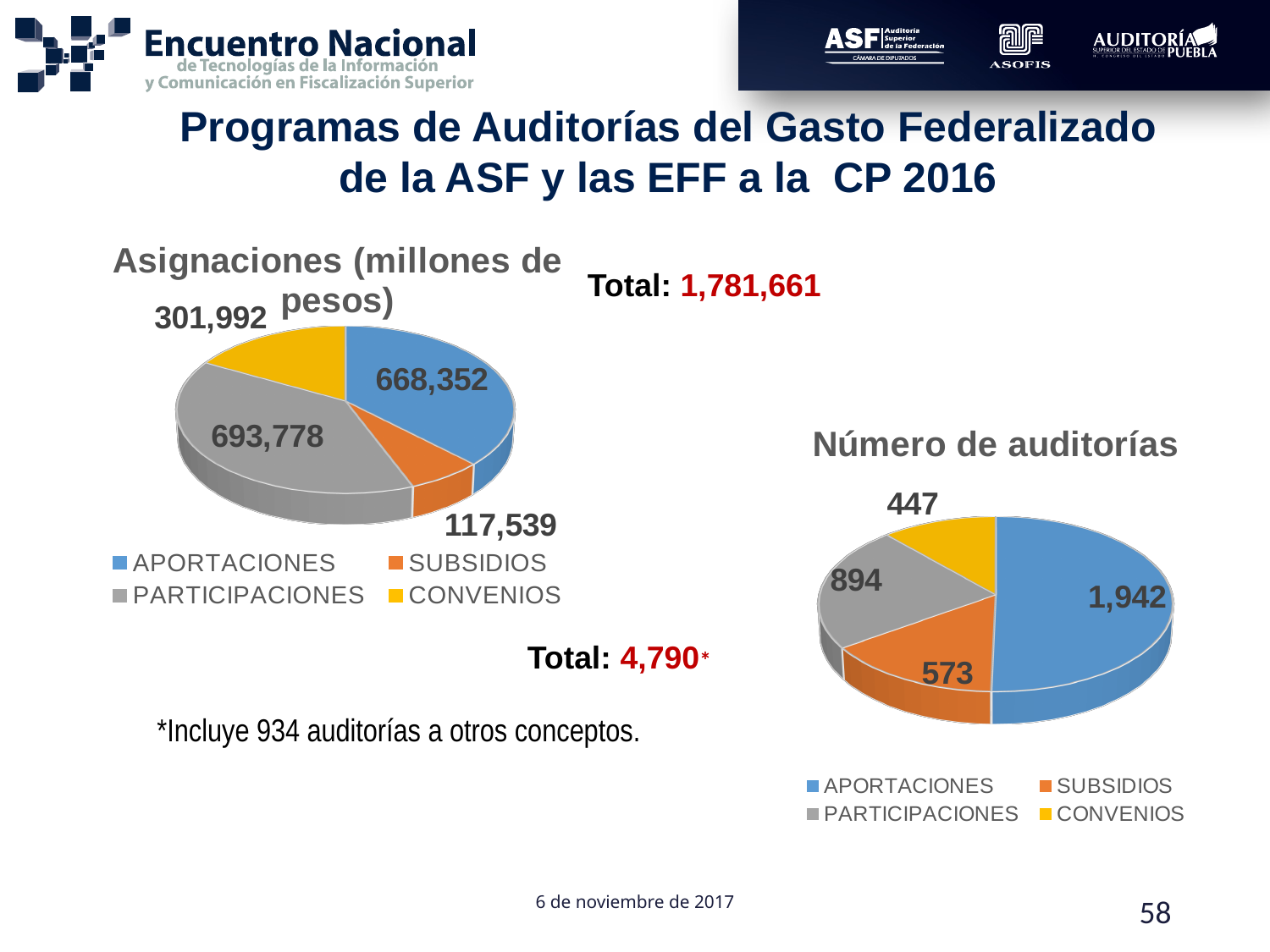
How many categories does the 'Número de auditorías' chart show? 4 In the 'Número de auditorías' chart, which category has the smallest value? CONVENIOS In the 'Asignaciones (millones de pesos)' chart, which category has the largest value? PARTICIPACIONES In the 'Asignaciones (millones de pesos)' chart, which category has the smallest value? SUBSIDIOS In the 'Asignaciones (millones de pesos)' chart, what is the value for PARTICIPACIONES? 693,778 In the 'Número de auditorías' chart, what is the value for CONVENIOS? 447 What kind of chart is the 'Asignaciones (millones de pesos)' chart? Pie chart In the 'Número de auditorías' chart, which is larger, SUBSIDIOS or PARTICIPACIONES? PARTICIPACIONES In the 'Asignaciones (millones de pesos)' chart, what is the difference between PARTICIPACIONES and APORTACIONES? 25,426 In the 'Número de auditorías' chart, what is the difference between APORTACIONES and PARTICIPACIONES? 1,048 In the 'Número de auditorías' chart, what is the value for APORTACIONES? 1,942 In the 'Asignaciones (millones de pesos)' chart, what is the value for SUBSIDIOS? 117,539